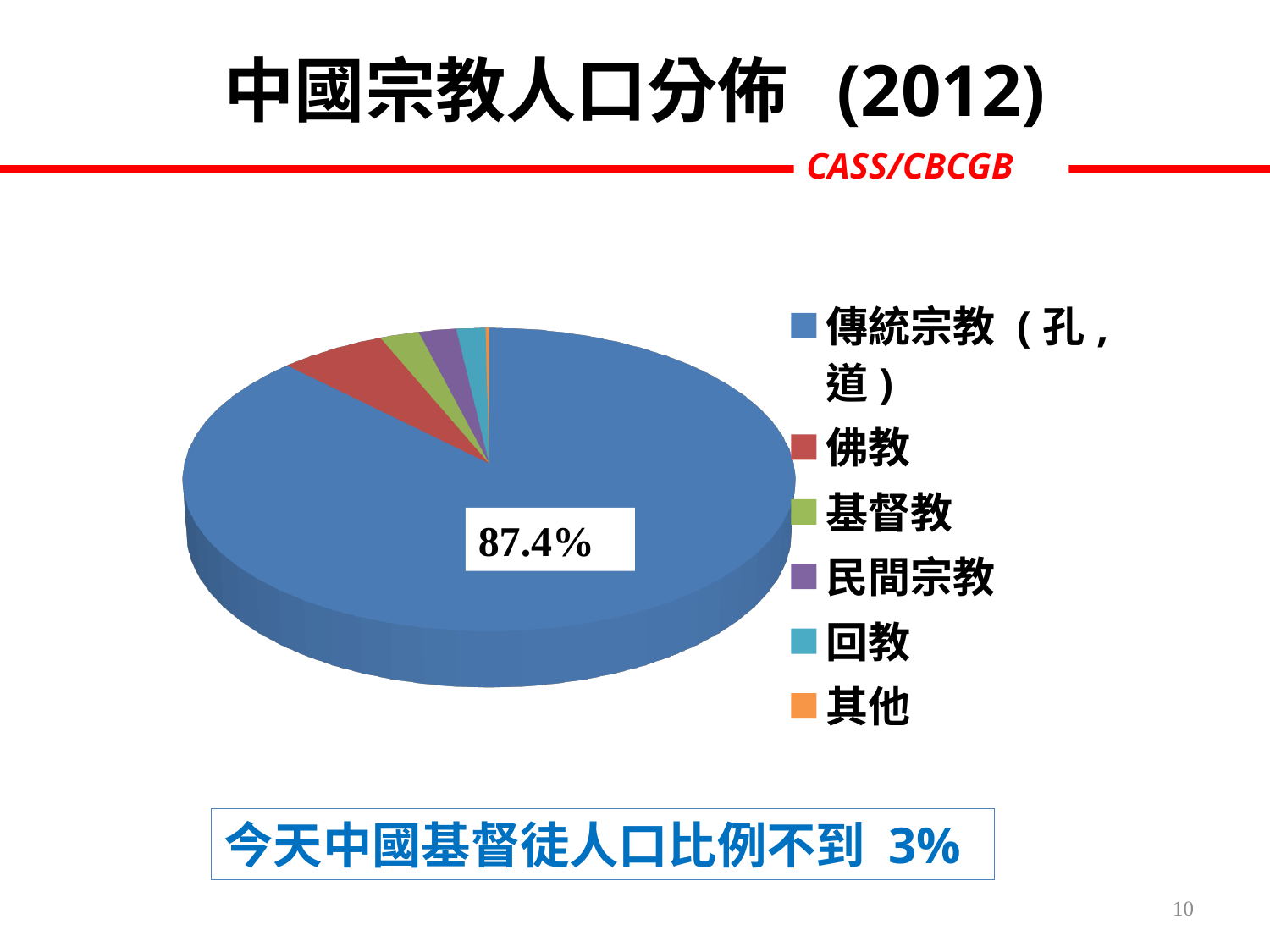
Which slice is larger, 基督教 or 其他? 基督教 What kind of chart is shown on the slide? pie chart What colour is the 佛教 slice in the pie chart? red What value is printed on the largest slice of the pie chart? 87.4% How many categories does the pie chart's legend list? 6 Which category is listed last in the pie chart's legend? 其他 Which slice is larger, 佛教 or 基督教? 佛教 Which slice is larger, 傳統宗教（孔，道）or 佛教? 傳統宗教（孔，道） What share of the pie does 傳統宗教（孔，道）represent? 87.4% Which category has the largest slice in the pie chart? 傳統宗教（孔，道） Which category has the smallest slice in the pie chart? 其他 What is the title of the chart on the slide? 中國宗教人口分佈 (2012)